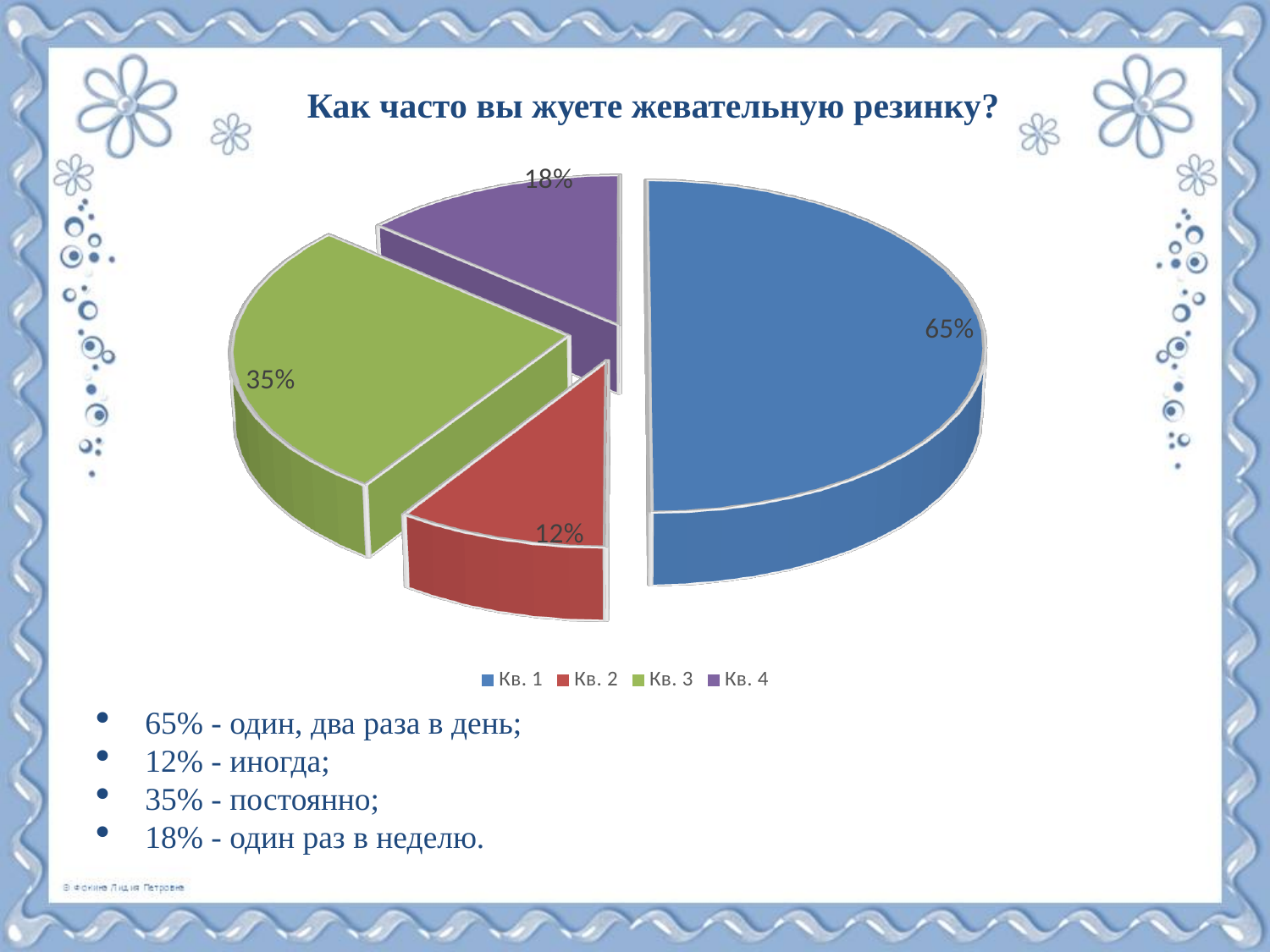
What is the difference between the values for Кв. 1 and Кв. 3? 30% What type of chart is shown on the slide? pie chart How many entries does the legend list? 4 What is the title of the chart? Как часто вы жуете жевательную резинку? Which category has the largest slice in the pie chart? Кв. 1 How many slices does the pie chart have? 4 What is the value shown for Кв. 1 in the pie chart? 65% What is the value shown for Кв. 2 in the pie chart? 12% What is the value shown for Кв. 3 in the pie chart? 35% Which is larger, the value for Кв. 3 or the value for Кв. 4? Кв. 3 Which category has the smallest slice in the pie chart? Кв. 2 What is the value shown for Кв. 4 in the pie chart? 18%